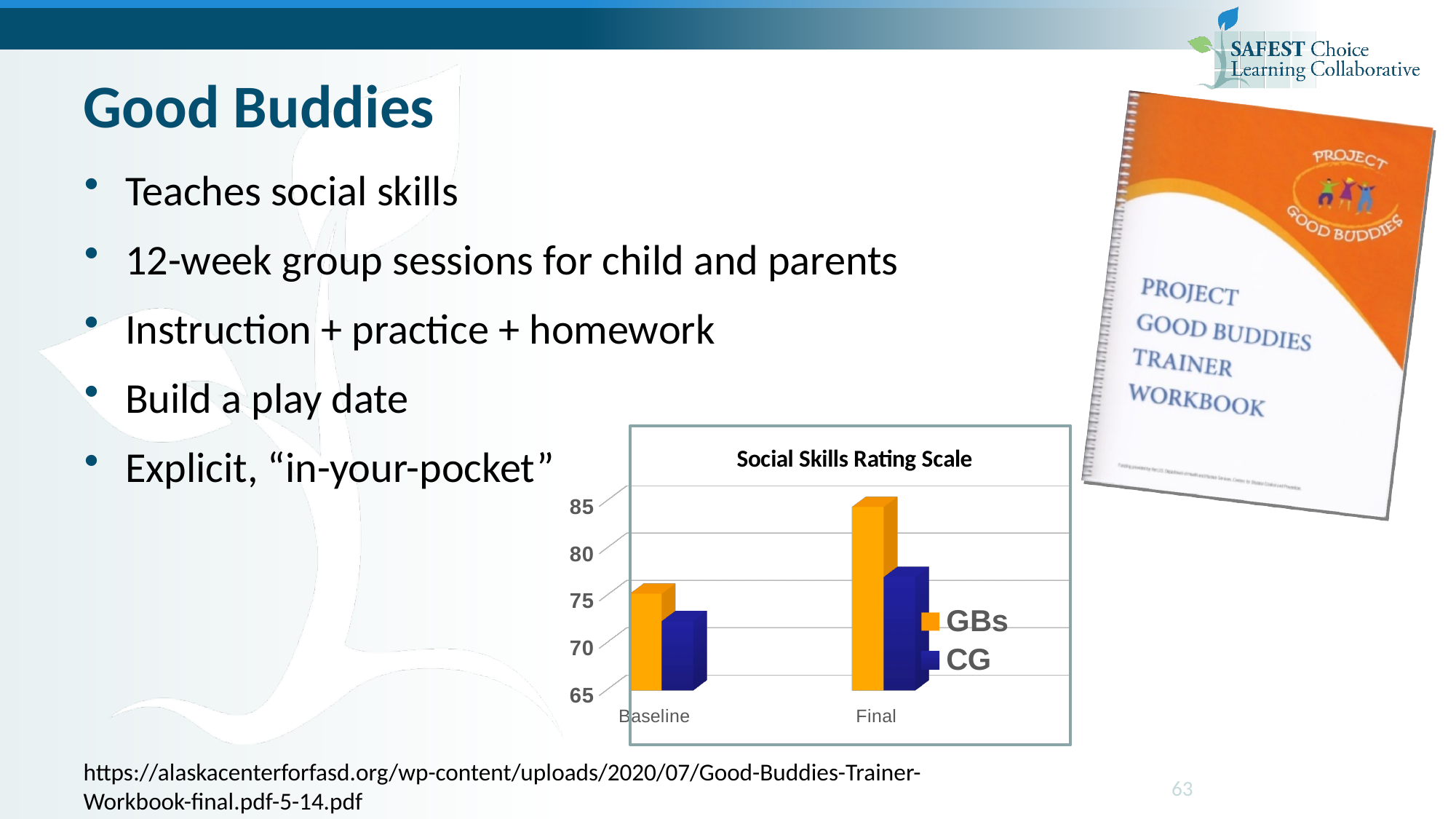
In the Social Skills Rating Scale chart, is the CG value at Baseline greater or less than 75? less In the Social Skills Rating Scale chart, which series has the larger value at Final, GBs or CG? GBs What is the title of the chart on the slide? Social Skills Rating Scale What type of chart is shown under the title 'Social Skills Rating Scale'? bar chart Which series is shown in orange in the Social Skills Rating Scale chart? GBs In the Social Skills Rating Scale chart, do the GBs values rise or fall from Baseline to Final? rise In the Social Skills Rating Scale chart, is the GBs value at Baseline greater or less than 70? greater In the Social Skills Rating Scale chart, which bar is the highest overall? GBs at Final How many categories are shown on the x axis of the Social Skills Rating Scale chart? 2 How many series does the legend of the Social Skills Rating Scale chart list? 2 In the Social Skills Rating Scale chart, is the CG value at Final greater or less than 75? greater